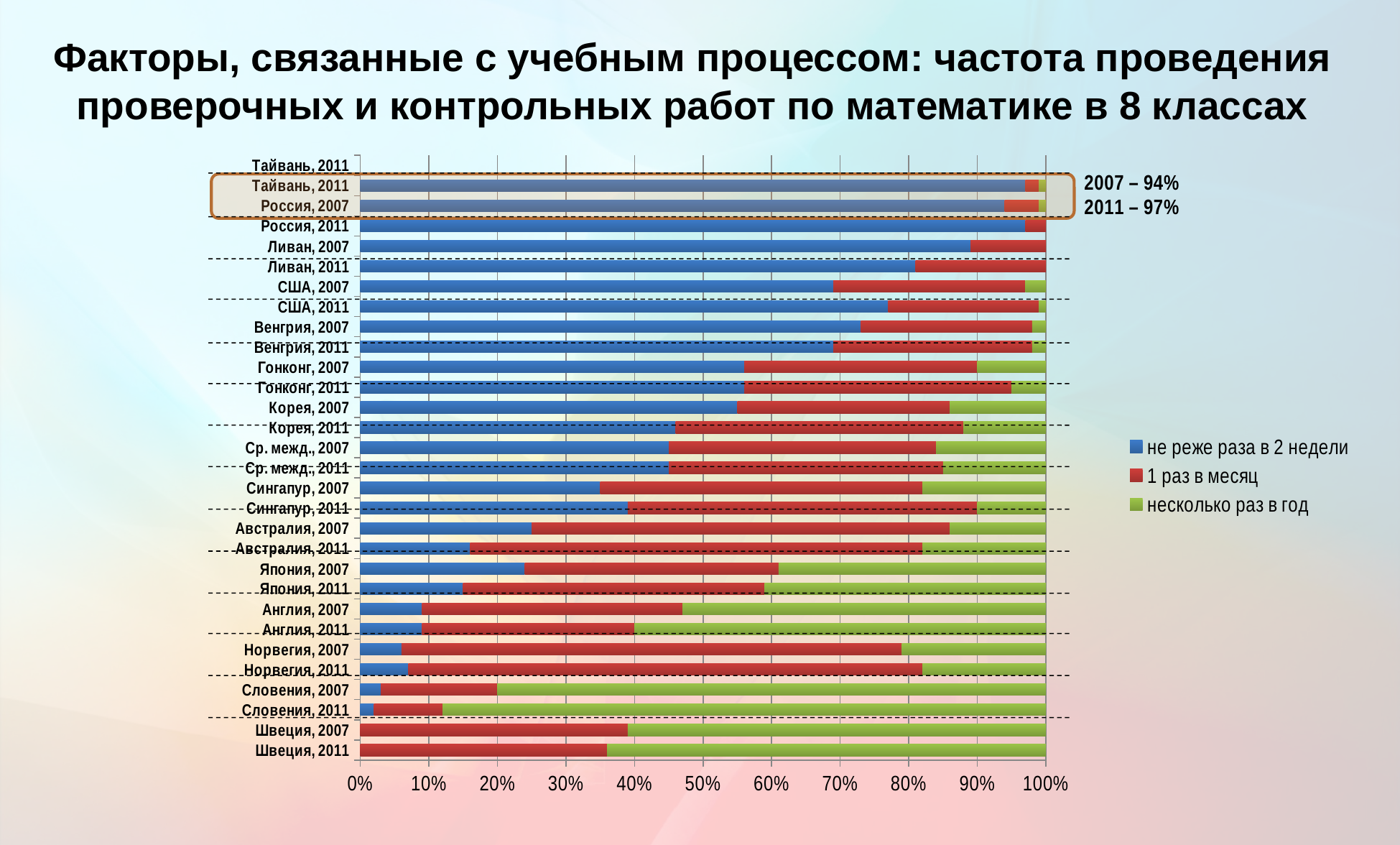
Is the blue segment (не реже раза в 2 недели) for Япония, 2007 greater or less than 20%? greater What percentages are written in the annotation next to the highlighted rows at the top of the chart? 2007 – 94%, 2011 – 97% Which has the larger blue segment (не реже раза в 2 недели): Ливан, 2007 or США, 2007? Ливан, 2007 Is the blue segment (не реже раза в 2 недели) for Сингапур, 2007 greater or less than 40%? less Which series does the blue colour represent in the legend? не реже раза в 2 недели Is the green segment (несколько раз в год) for Словения, 2011 greater or less than 80%? greater Which has the larger blue segment (не реже раза в 2 недели): Австралия, 2007 or Япония, 2011? Австралия, 2007 Which category has the largest green segment (несколько раз в год)? Словения, 2011 What kind of chart is shown on the slide? Stacked bar chart How many series does the legend list? 3